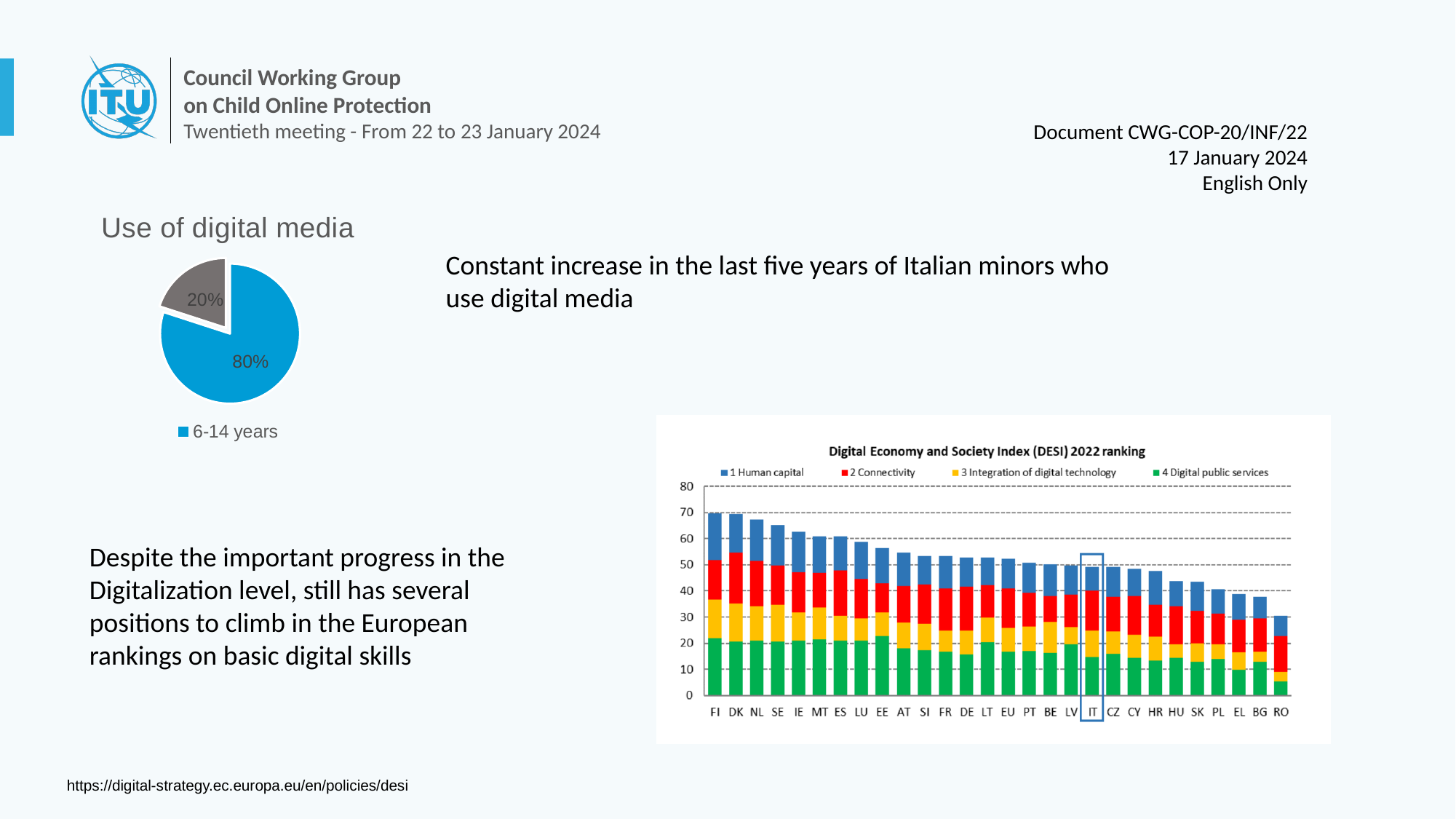
In the 'Digital Economy and Society Index (DESI) 2022 ranking' chart, which category has the lowest total bar? RO In the 'Digital Economy and Society Index (DESI) 2022 ranking' chart, do the total bar values rise or fall from left to right along the x axis? fall How many series does the legend of the 'Digital Economy and Society Index (DESI) 2022 ranking' chart list? 4 What kind of chart is the 'Use of digital media' chart? pie chart In the pie chart titled 'Use of digital media', what is the value of the larger (blue) slice? 80% In the 'Digital Economy and Society Index (DESI) 2022 ranking' chart, is the total value for FI greater or less than 60? greater In the 'Digital Economy and Society Index (DESI) 2022 ranking' chart, which has the larger total bar, DK or IT? DK How many countries/categories are shown on the x axis of the 'Digital Economy and Society Index (DESI) 2022 ranking' chart? 28 In the pie chart titled 'Use of digital media', what is the value of the grey slice? 20% What kind of chart is the 'Digital Economy and Society Index (DESI) 2022 ranking' chart? stacked bar chart In the 'Use of digital media' pie chart, what age group does the legend list? 6-14 years